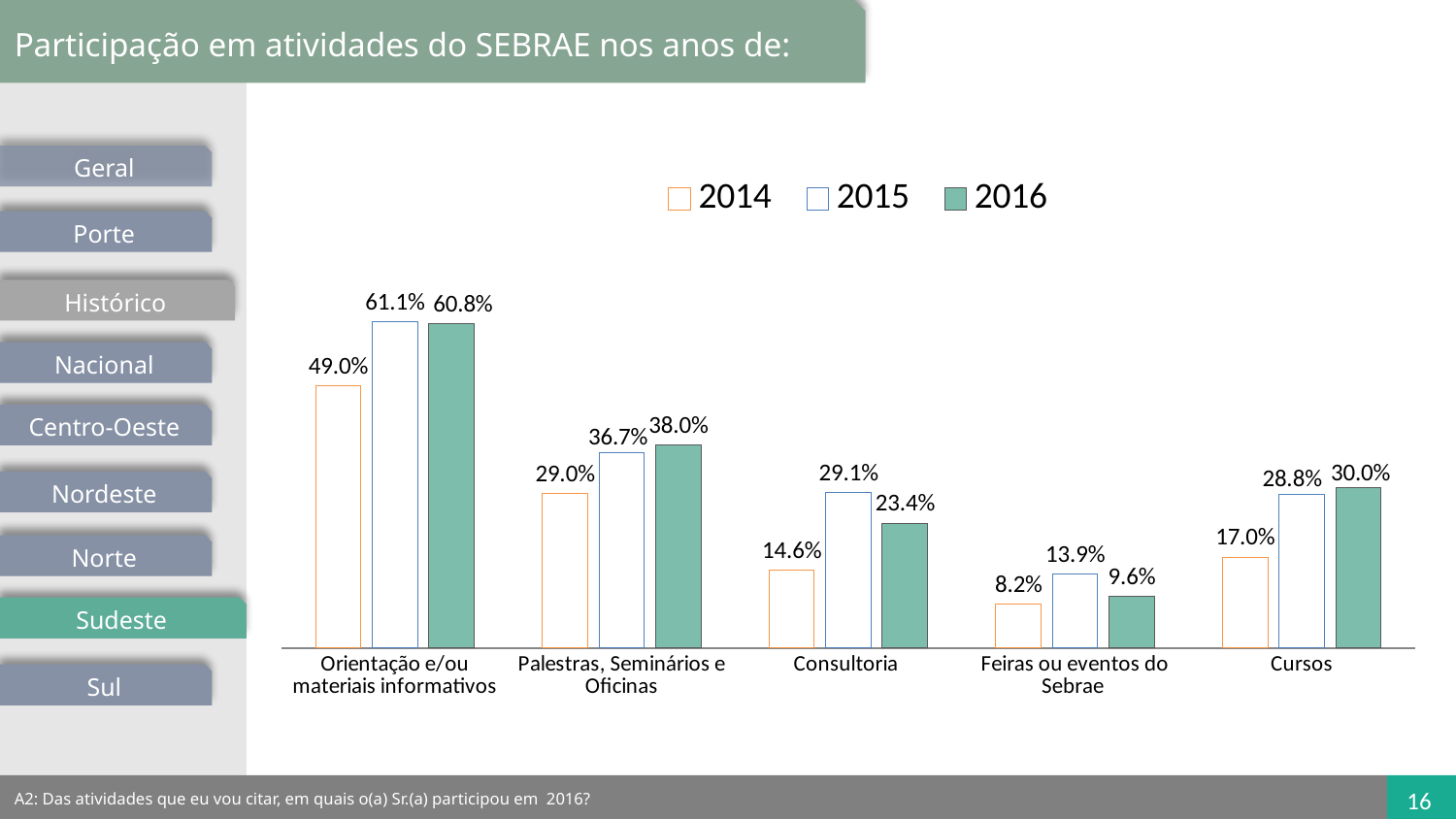
Which is larger for 'Consultoria': the 2015 value or the 2016 value? 2015 What kind of chart is shown on the slide? Bar chart How many series does the legend list? 3 Which category has the highest value for 2015? Orientação e/ou materiais informativos Which series is shown with filled green bars in the legend? 2016 Which category has the lowest value for 2014? Feiras ou eventos do Sebrae What is the difference between the 2015 and 2014 values for 'Orientação e/ou materiais informativos'? 12.1% What is the value for 2015 in the 'Feiras ou eventos do Sebrae' category? 13.9% What is the value for 2014 in the 'Cursos' category? 17.0% What is the difference between the 2016 and 2015 values for 'Palestras, Seminários e Oficinas'? 1.3% What is the value for 2016 in the 'Consultoria' category? 23.4% How many categories are shown on the x axis? 5